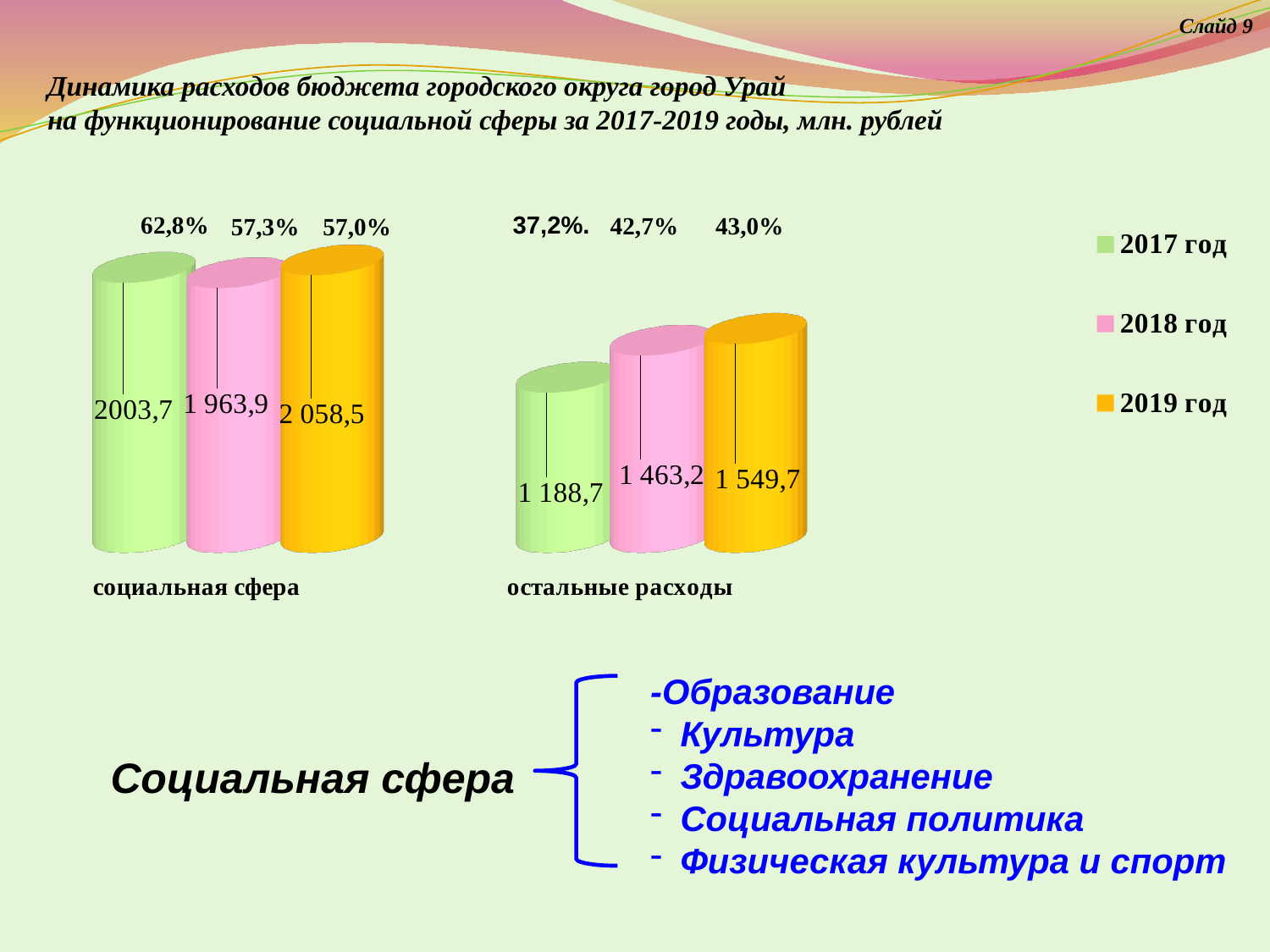
What is the value for социальная сфера in 2019? 2 058,5 Which is larger: the 2017 value for социальная сфера or the 2017 value for остальные расходы? социальная сфера What percentage is shown above the 2017 bar for социальная сфера? 62,8% Which year has the highest value for социальная сфера? 2019 год How many series does the legend list? 3 What is the value for остальные расходы in 2018? 1 463,2 What is the value for социальная сфера in 2017? 2003,7 Which year has the lowest value for остальные расходы? 2017 год What is the value for остальные расходы in 2017? 1 188,7 What is the difference between the 2019 and 2018 values for остальные расходы? 86,5 Do the values for остальные расходы rise or fall from 2017 to 2019? rise What is the difference between the 2019 and 2018 values for социальная сфера? 94,6